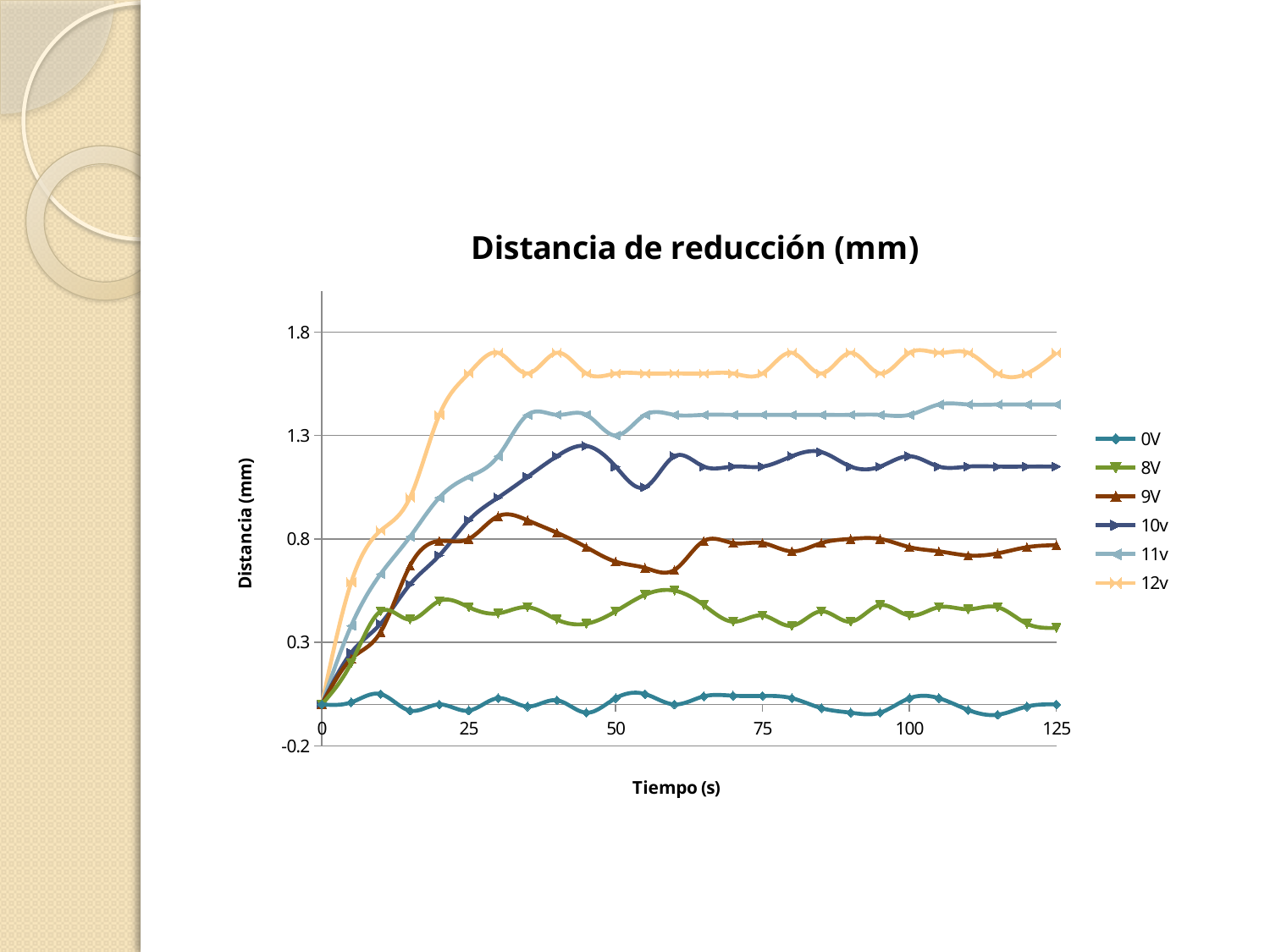
What is the label of the x axis? Tiempo (s) Does the 12v series rise or fall between 0 s and 25 s? rise Is the value for 0V at 125 s greater or less than 0.3? less Is the value for 10v at 125 s greater or less than 1.3? less Which series has the lowest value at 125 s? 0V At 125 s, which series has the larger value, 11v or 10v? 11v How many series does the legend list? 6 Is the value for 12v at 125 s greater or less than 1.3? greater What kind of chart is shown on the slide? line chart Which series has the highest value at 125 s? 12v What is the title of the chart? Distancia de reducción (mm)